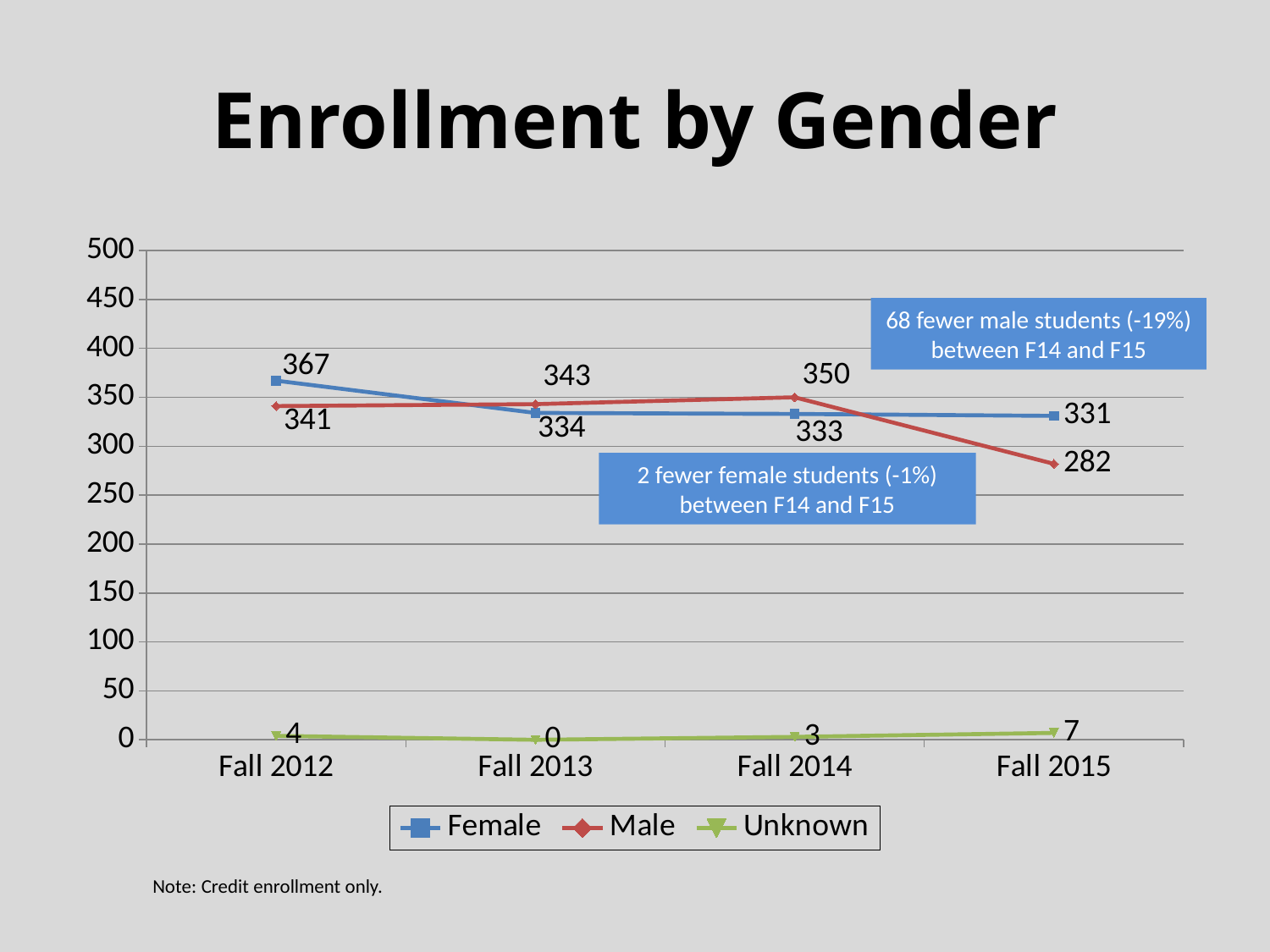
What is the Female enrollment in Fall 2012? 367 Does Female enrollment rise or fall from Fall 2012 to Fall 2015? fall Is the Male enrollment in Fall 2015 greater or less than 300? less In which term is Male enrollment highest? Fall 2014 What is the Male enrollment in Fall 2015? 282 What kind of chart is shown? line chart Which is larger in Fall 2013, Female or Male enrollment? Male How many terms are shown on the x axis? 4 In which term is Female enrollment lowest? Fall 2015 What is the difference between Male enrollment in Fall 2014 and Fall 2015? 68 How many series does the legend list? 3 What is the Unknown enrollment in Fall 2014? 3